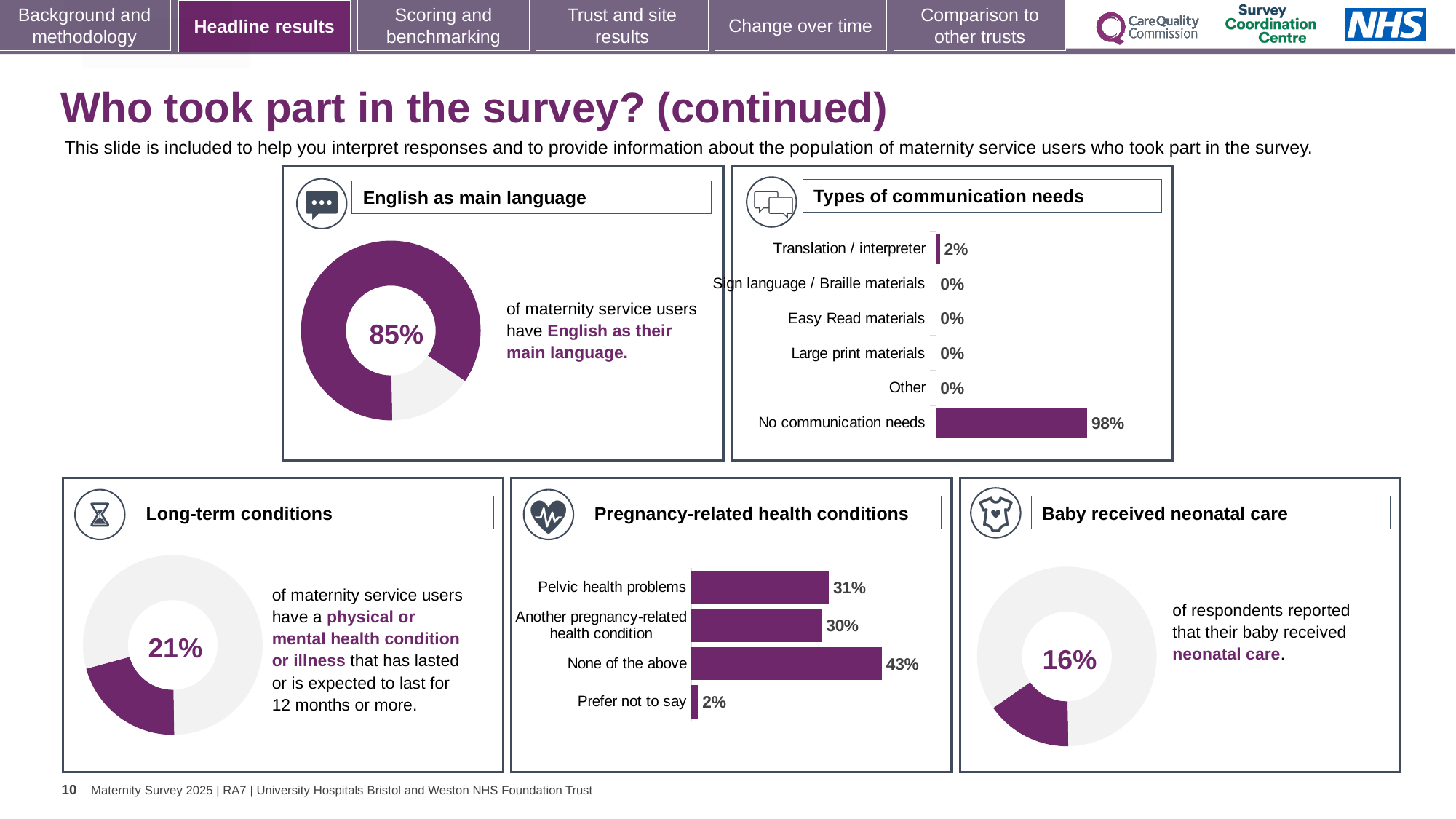
In the 'Baby received neonatal care' chart, what percentage of respondents reported that their baby received neonatal care? 16% In the 'Types of communication needs' chart, what is the value for 'No communication needs'? 98% In the 'Pregnancy-related health conditions' chart, what is the value for 'Pelvic health problems'? 31% How many categories are shown in the 'Types of communication needs' chart? 6 In the 'Types of communication needs' chart, what is the value for 'Translation / interpreter'? 2% In the 'Pregnancy-related health conditions' chart, which category has the highest value? None of the above In the 'Pregnancy-related health conditions' chart, which category has the lowest value? Prefer not to say In the 'Types of communication needs' chart, which category has the highest value? No communication needs In the 'Pregnancy-related health conditions' chart, what is the difference between 'None of the above' and 'Another pregnancy-related health condition'? 13% In the 'English as main language' chart, what percentage of maternity service users have English as their main language? 85% What type of chart is used in the 'Pregnancy-related health conditions' panel? Bar chart In the 'Long-term conditions' chart, what percentage of maternity service users have a physical or mental health condition or illness? 21%